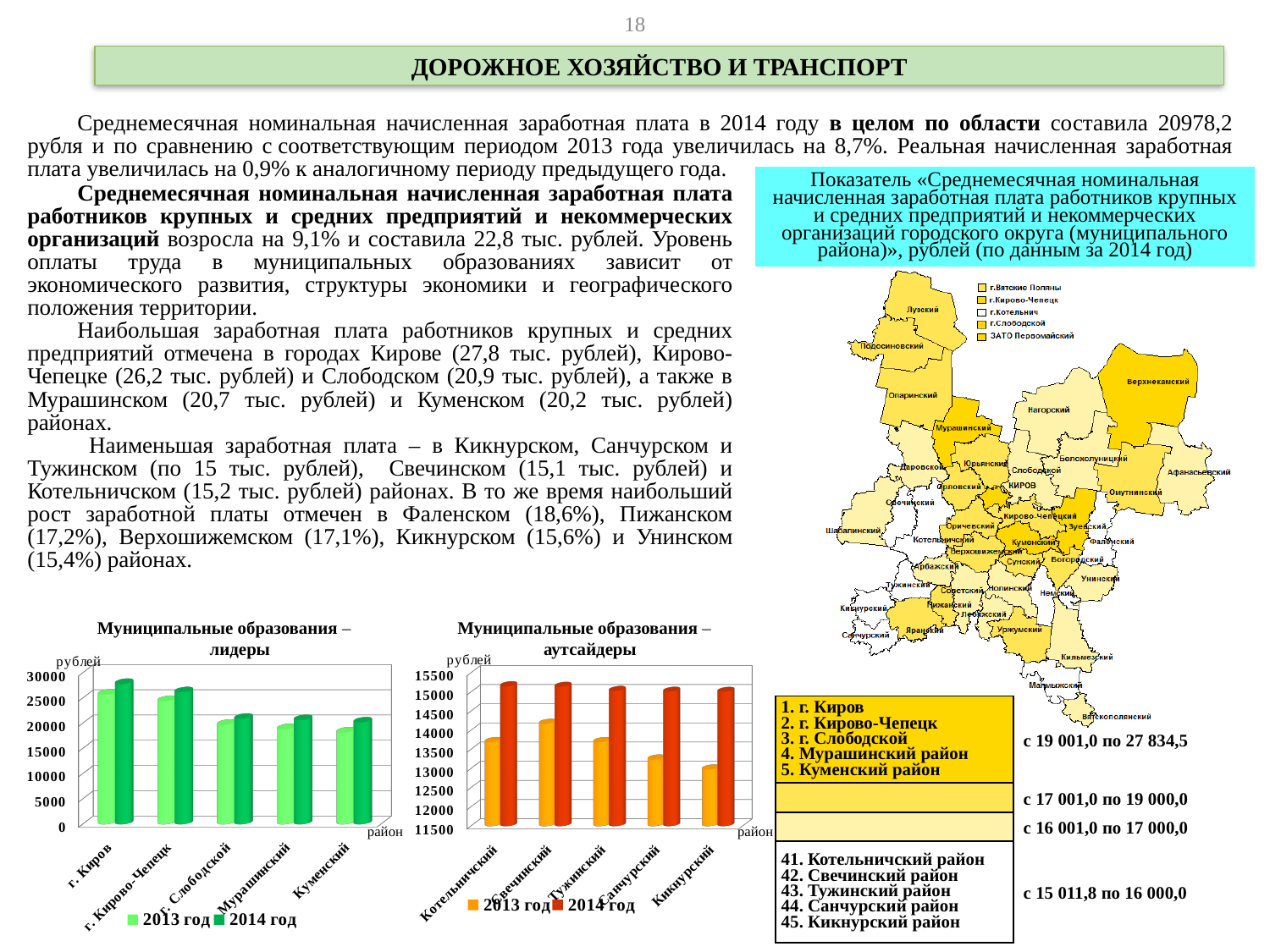
On the 'Муниципальные образования – лидеры' chart, which is larger for 2014 год: г. Киров or Куменский? г. Киров What unit is labelled on the vertical axis of the 'Муниципальные образования – аутсайдеры' chart? рублей On the 'Муниципальные образования – лидеры' chart, which municipality has the highest value for 2014 год? г. Киров On the 'Муниципальные образования – аутсайдеры' chart, which municipality has the highest value for 2013 год? Свечинский What kind of chart is the 'Муниципальные образования – лидеры' chart? bar chart On the 'Муниципальные образования – аутсайдеры' chart, is the 2013 год value for Кикнурский greater or less than 13500? less On the 'Муниципальные образования – аутсайдеры' chart, is the 2014 год value for Котельничский greater or less than 15000? greater How many series does the legend of the 'Муниципальные образования – лидеры' chart list? 2 On the 'Муниципальные образования – лидеры' chart, is the 2014 год value for г. Киров greater or less than 25000? greater On the 'Муниципальные образования – лидеры' chart, do the 2014 год values rise or fall from left to right across the municipalities? fall How many municipalities are shown on the 'Муниципальные образования – аутсайдеры' chart? 5 On the 'Муниципальные образования – аутсайдеры' chart, which municipality has the lowest value for 2013 год? Кикнурский